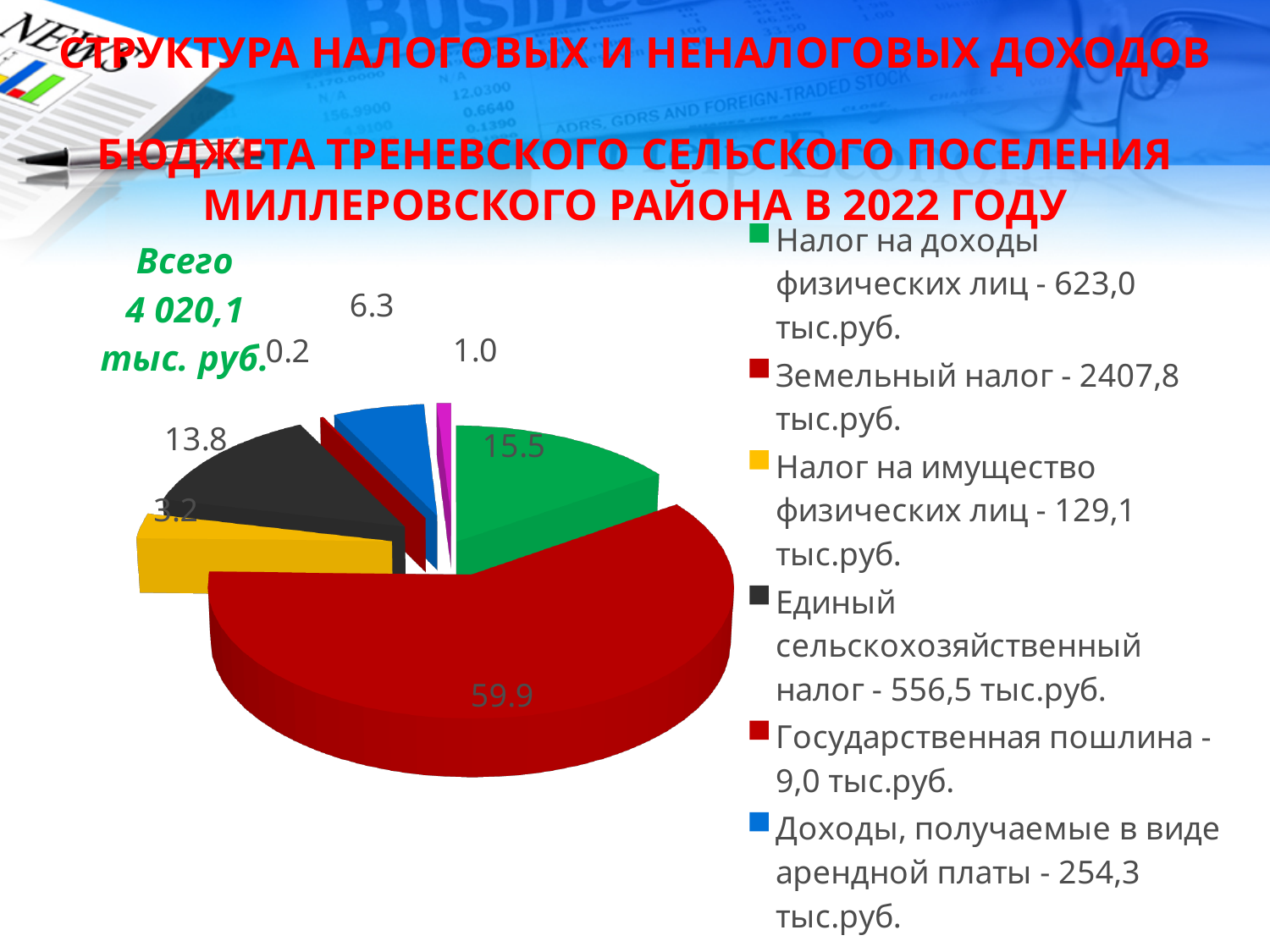
What kind of chart is shown on the slide? pie chart What value is labelled on the Доходы, получаемые в виде арендной платы slice? 6.3 What value is labelled on the Единый сельскохозяйственный налог slice? 13.8 What percentage share does the Земельный налог slice show on the pie chart? 59.9 How many slices does the pie chart have? 7 Which category has the largest slice of the pie chart? Земельный налог What total amount is stated next to the pie chart (Всего)? 4 020,1 тыс. руб. What value is labelled on the Налог на доходы физических лиц slice of the pie chart? 15.5 According to the legend, what amount in тыс.руб. is given for Земельный налог? 2407,8 тыс.руб. Which labelled slice of the pie chart is the smallest? Государственная пошлина (0.2) Which is larger: the Налог на имущество физических лиц slice or the Единый сельскохозяйственный налог slice? Единый сельскохозяйственный налог What is the difference between the Земельный налог slice (59.9) and the Налог на доходы физических лиц slice (15.5)? 44.4